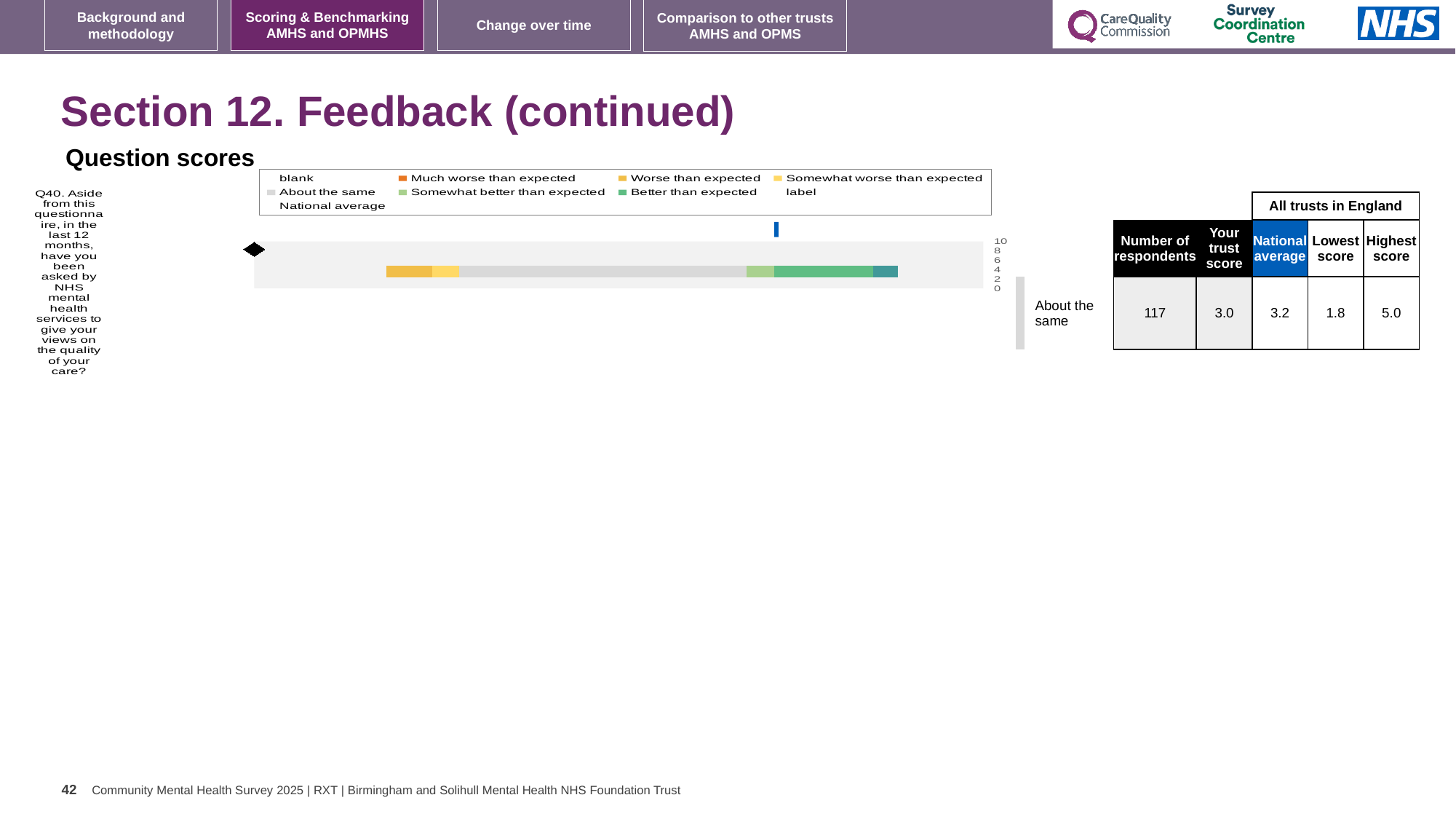
In the table beside the chart, what is 'Your trust score' for Q40? 3.0 How many questions (categories) are plotted in the Question scores chart? 1 In the table beside the chart, what is the National average for Q40? 3.2 Which question number is plotted in the Question scores chart? Q40 In the table beside the chart, what is the Lowest score among all trusts in England for Q40? 1.8 In the legend of the Question scores chart, which entry is shown in grey? About the same How many entries does the legend of the Question scores chart list? 9 For Q40, which is larger: 'Your trust score' or the National average? National average What kind of chart is shown under 'Question scores'? bar chart In the table beside the chart, what is the number of respondents for Q40? 117 For Q40, what is the difference between the Highest score and the Lowest score in the table? 3.2 In the table beside the chart, what is the Highest score among all trusts in England for Q40? 5.0